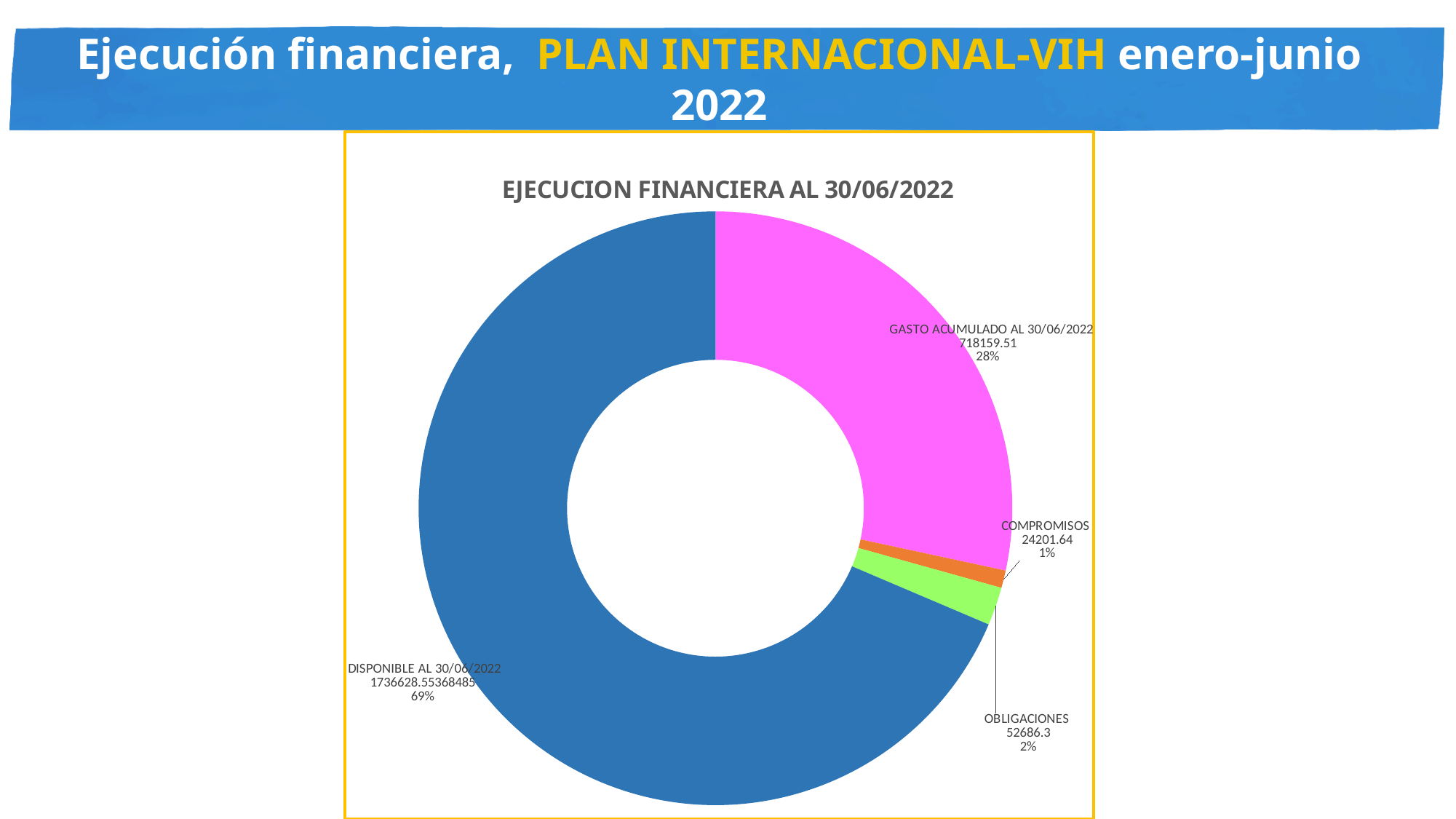
What is the value for DISPONIBLE AL 30/06/2022? 1736628.55368485 How many categories are shown in the chart? 4 What share of the chart does DISPONIBLE AL 30/06/2022 represent? 69% What is the value for GASTO ACUMULADO AL 30/06/2022? 718159.51 Which is larger, OBLIGACIONES or COMPROMISOS? OBLIGACIONES What is the value for OBLIGACIONES? 52686.3 What share of the chart does OBLIGACIONES represent? 2% What share of the chart does GASTO ACUMULADO AL 30/06/2022 represent? 28% What is the value for COMPROMISOS? 24201.64 Which category has the smallest slice? COMPROMISOS Which category has the largest slice? DISPONIBLE AL 30/06/2022 What type of chart is shown? Pie chart (doughnut)